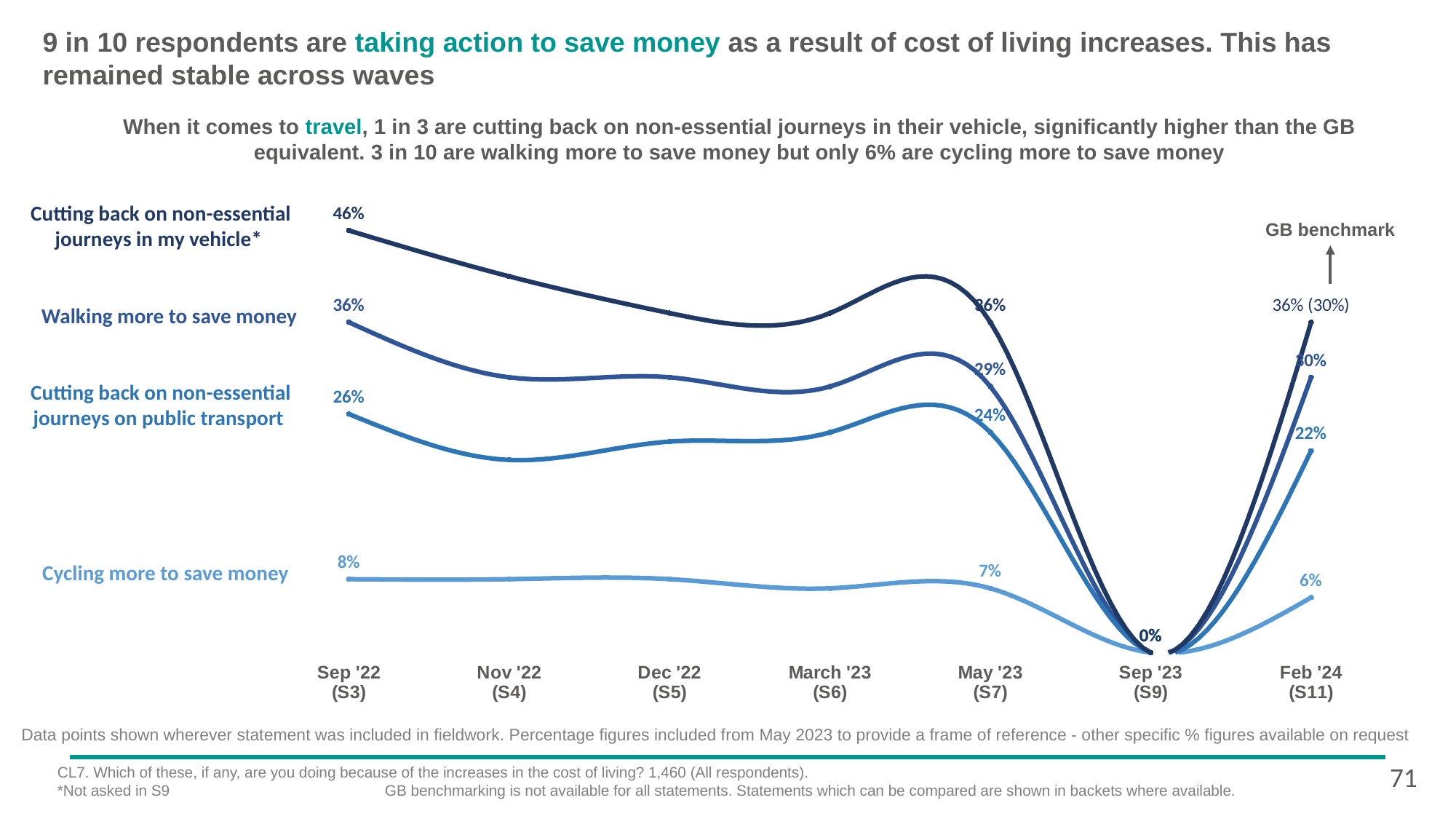
What is the value for 'Walking more to save money' at Sep '22 (S3)? 36% What is the value for 'Cutting back on non-essential journeys on public transport' at Feb '24 (S11)? 22% Is the value for 'Cutting back on non-essential journeys on public transport' higher at Sep '22 (S3) or at May '23 (S7)? Sep '22 (S3) How many series are plotted on the chart? 4 How many time points are shown on the x axis? 7 What is the value for 'Cutting back on non-essential journeys in my vehicle' at Sep '22 (S3)? 46% What kind of chart is shown on the slide? Line chart What is the value for 'Cycling more to save money' at Feb '24 (S11)? 6% Which series has the highest value at Sep '22 (S3)? Cutting back on non-essential journeys in my vehicle What is the value for 'Cycling more to save money' at May '23 (S7)? 7% Which series has the lowest value at Feb '24 (S11)? Cycling more to save money At Sep '22 (S3), what is the difference between 'Cutting back on non-essential journeys in my vehicle' and 'Walking more to save money'? 10 percentage points